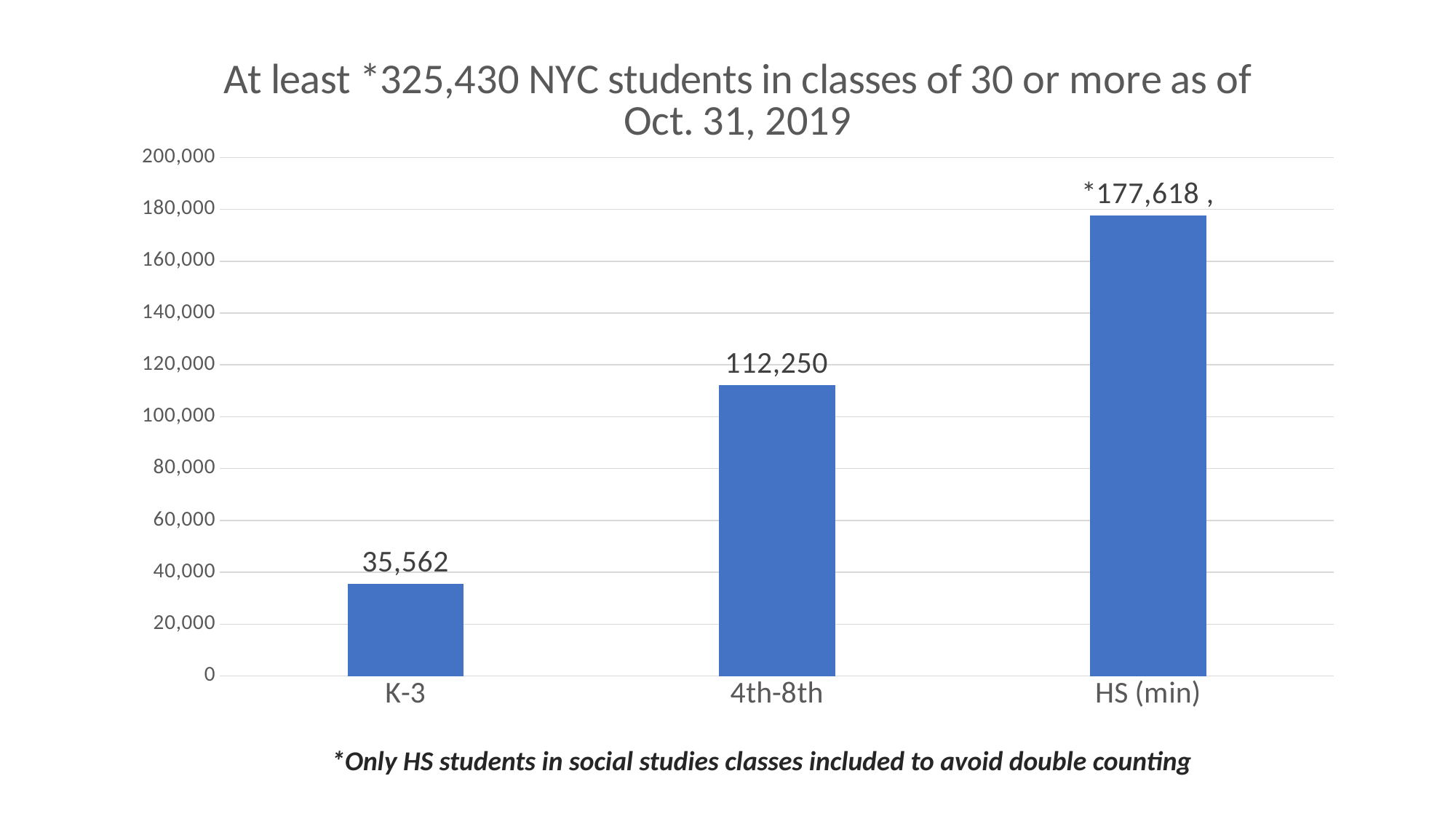
Is the value for HS (min) greater or less than 160,000? greater What kind of chart is shown on the slide? bar chart What is the value for HS (min)? 177,618 Which is larger, the value for K-3 or the value for 4th-8th? 4th-8th What is the value for K-3? 35,562 How many categories are shown on the x axis? 3 Which category has the lowest value? K-3 Do the values rise or fall from K-3 to HS (min) along the x axis? rise What is the difference between the values for HS (min) and 4th-8th? 65,368 What is the value for 4th-8th? 112,250 Which category has the highest value? HS (min) What is the difference between the values for 4th-8th and K-3? 76,688